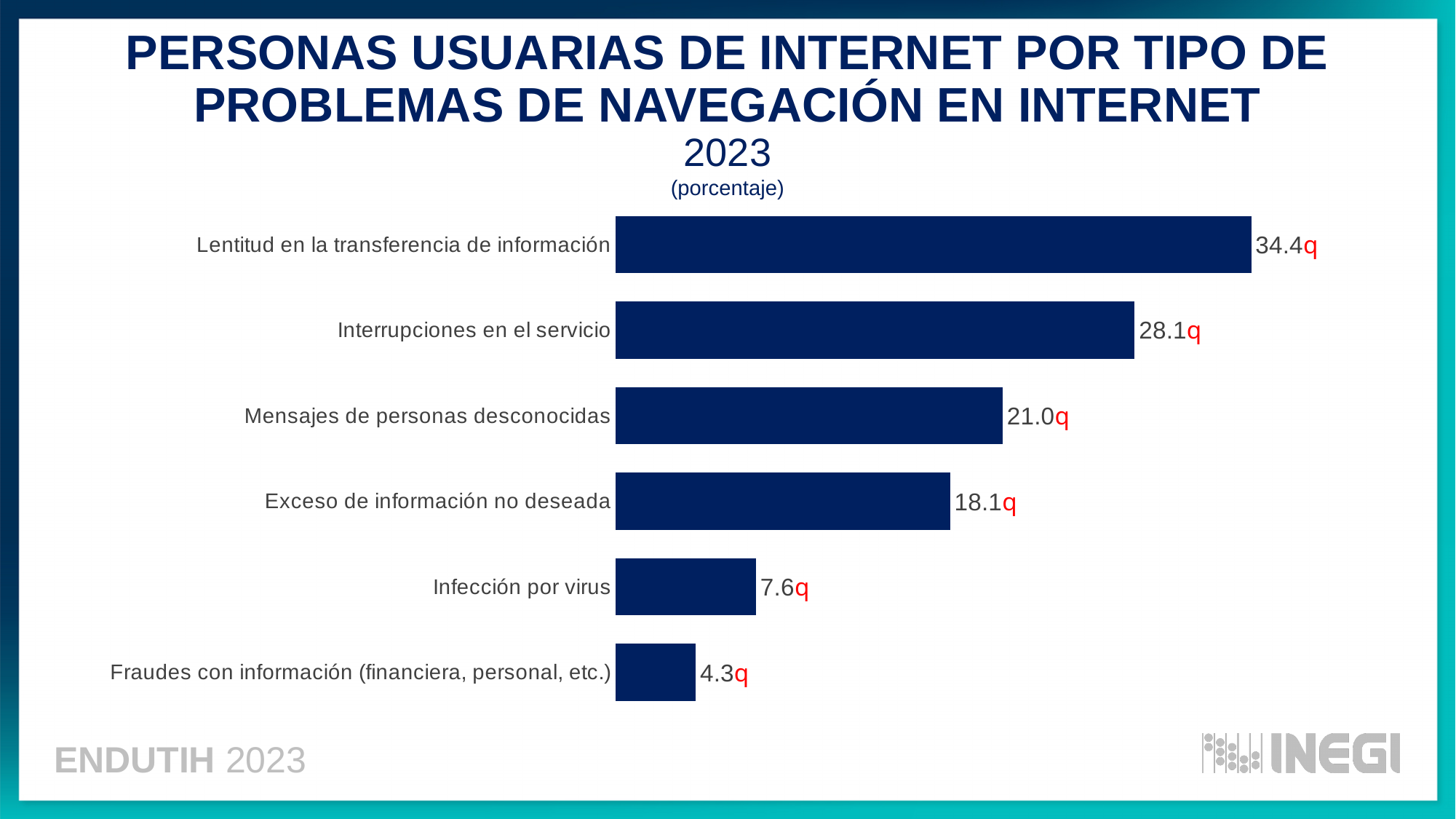
What is the difference between the values for Mensajes de personas desconocidas and Exceso de información no deseada? 2.9 Which category has the highest value? Lentitud en la transferencia de información How many categories are shown in the chart? 6 What kind of chart is shown on the slide? Bar chart What is the value for Interrupciones en el servicio? 28.1 What unit is indicated below the chart title? porcentaje What is the value for Lentitud en la transferencia de información? 34.4 What is the difference between the values for Lentitud en la transferencia de información and Interrupciones en el servicio? 6.3 Which is larger, the value for Mensajes de personas desconocidas or the value for Infección por virus? Mensajes de personas desconocidas What is the value for Fraudes con información (financiera, personal, etc.)? 4.3 Which category has the lowest value? Fraudes con información (financiera, personal, etc.) What is the value for Infección por virus? 7.6